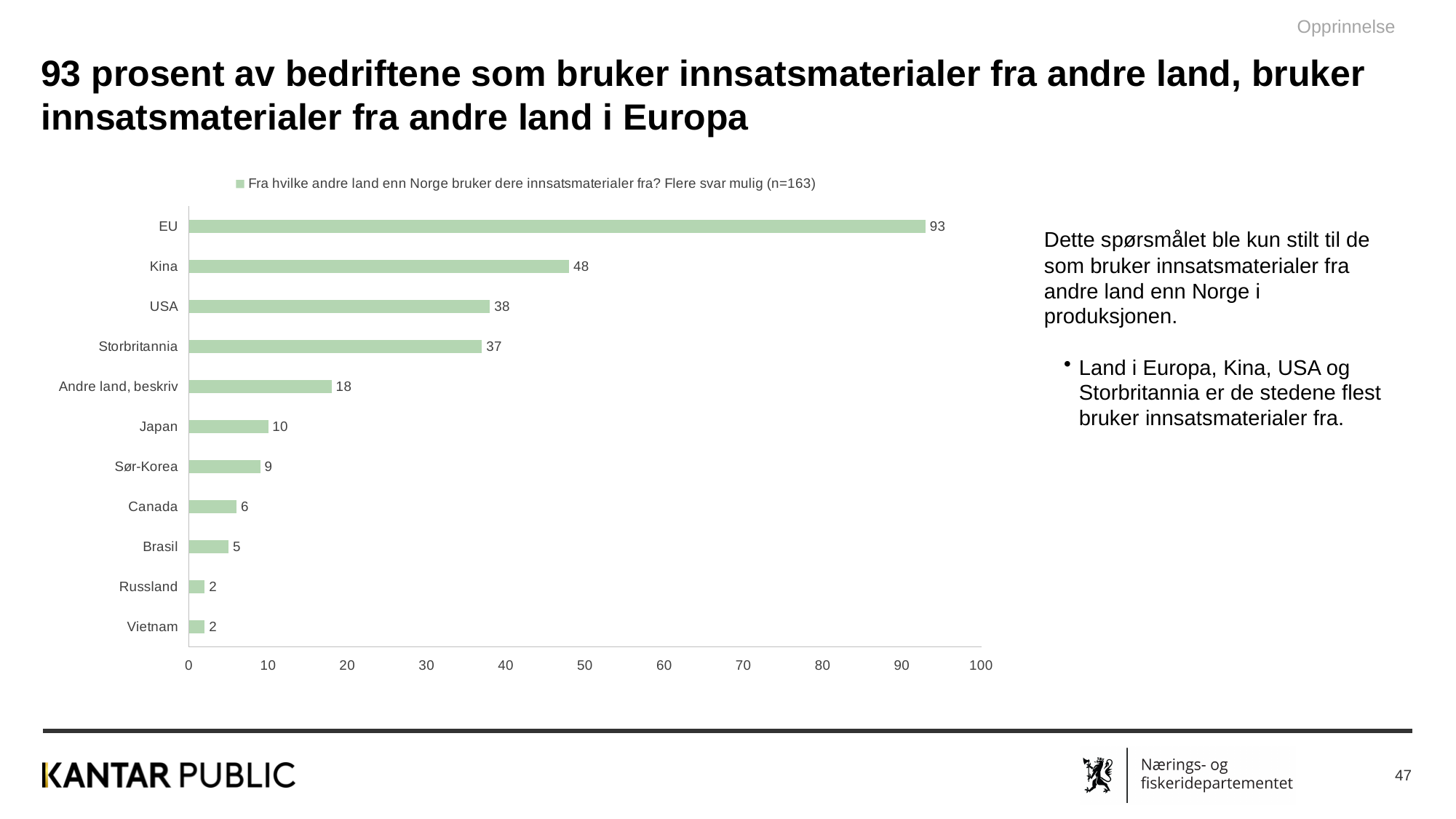
What is the value for Japan? 10 What is the difference between the values for Kina and USA? 10 What kind of chart is shown on the slide? bar chart How many categories are shown in the chart? 11 What is the value for Kina? 48 What is the value for Storbritannia? 37 Which category has the highest value? EU How many series does the legend list? 1 Is the value for Andre land, beskriv greater or less than 20? less What is the value for EU? 93 What is the sample size (n) given in the legend entry? n=163 Which is larger, the value for Canada or the value for Brasil? Canada